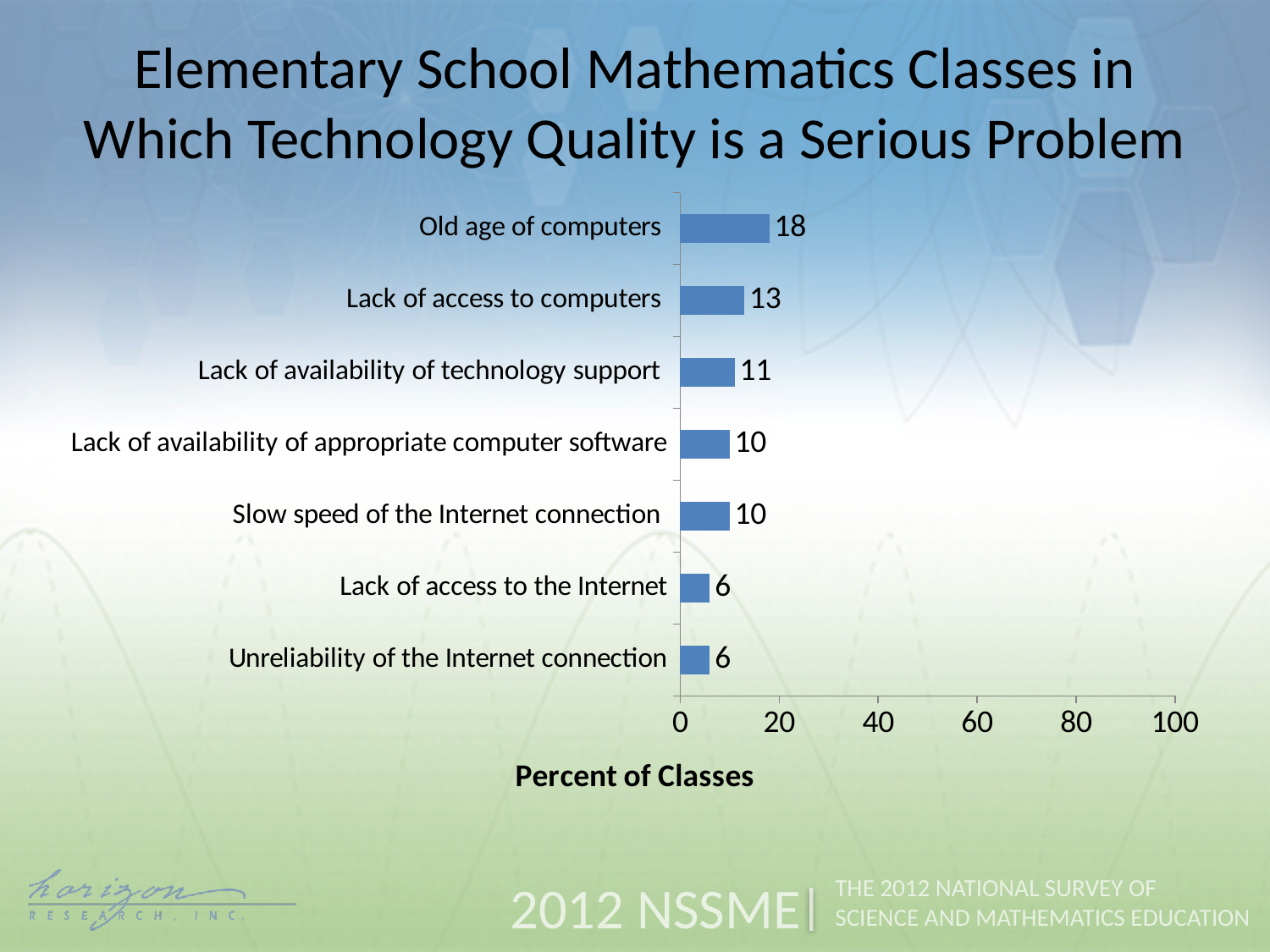
What is the label on the horizontal axis? Percent of Classes What is the maximum value shown on the horizontal axis? 100 What percent of classes report old age of computers as a serious problem? 18 Which category has the highest value? Old age of computers What is the difference between the values for old age of computers and lack of access to computers? 5 Is the value for old age of computers greater or less than 20? less How many categories are shown in the chart? 7 What is the value for lack of availability of technology support? 11 What is the value for lack of access to computers? 13 Which is larger: the value for lack of availability of technology support or the value for slow speed of the Internet connection? Lack of availability of technology support What kind of chart is shown on the slide? Bar chart What is the value for lack of access to the Internet? 6